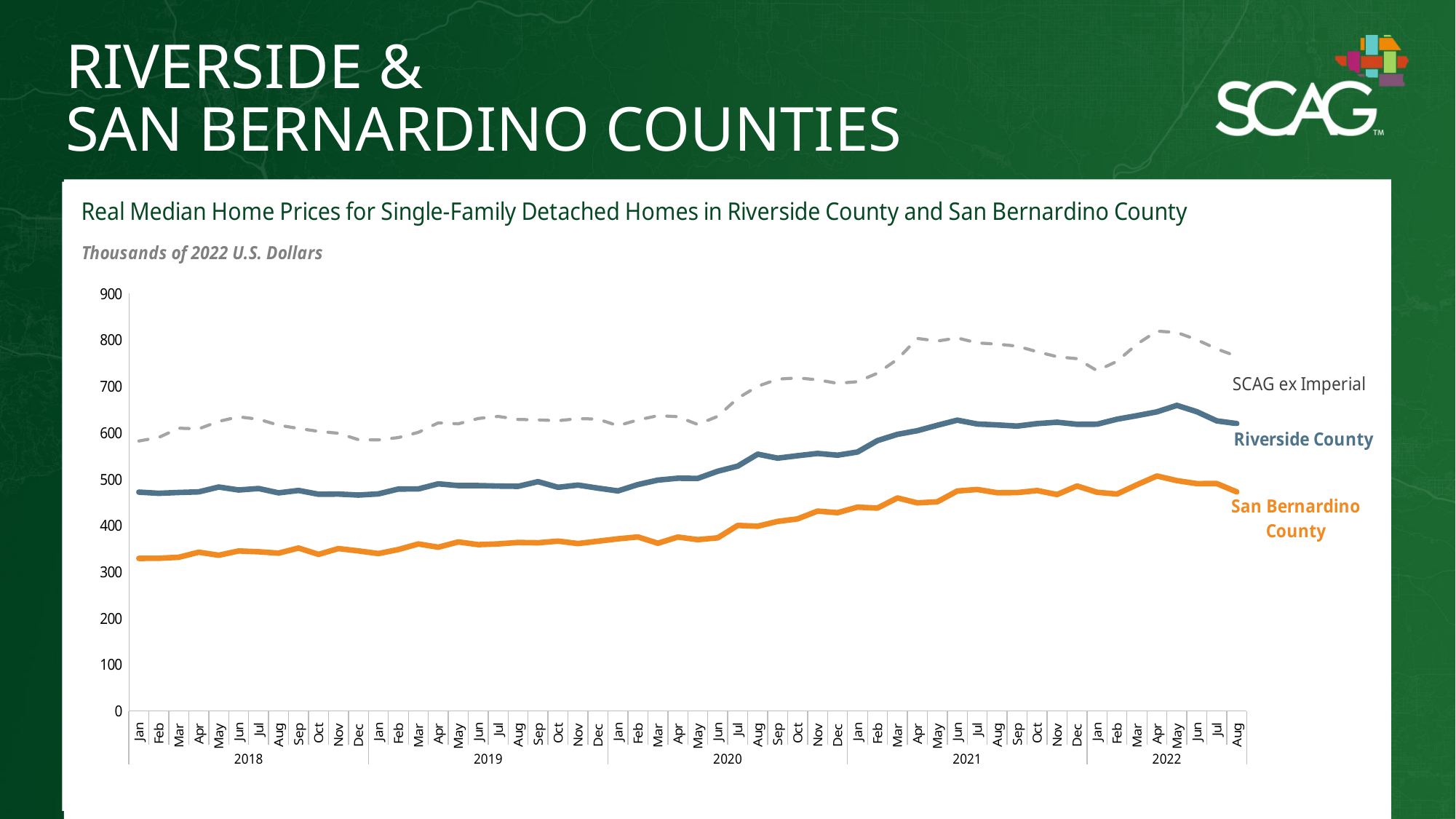
How many years are labeled along the x axis? 5 In Aug 2022, which is larger: the value for Riverside County or the value for San Bernardino County? Riverside County Does the San Bernardino County line generally rise or fall from Jan 2018 to Aug 2022? Rise What kind of chart is shown on the slide? Line chart Is the value for Riverside County in Jan 2018 greater or less than 500? less Which series has the lowest values throughout the chart? San Bernardino County Which series has the highest values throughout the chart? SCAG ex Imperial Is the value for SCAG ex Imperial in Apr 2022 greater or less than 700? greater In what units are the values on the chart expressed? Thousands of 2022 U.S. Dollars Is the value for San Bernardino County in Jan 2018 greater or less than 400? less How many series are plotted on the chart? 3